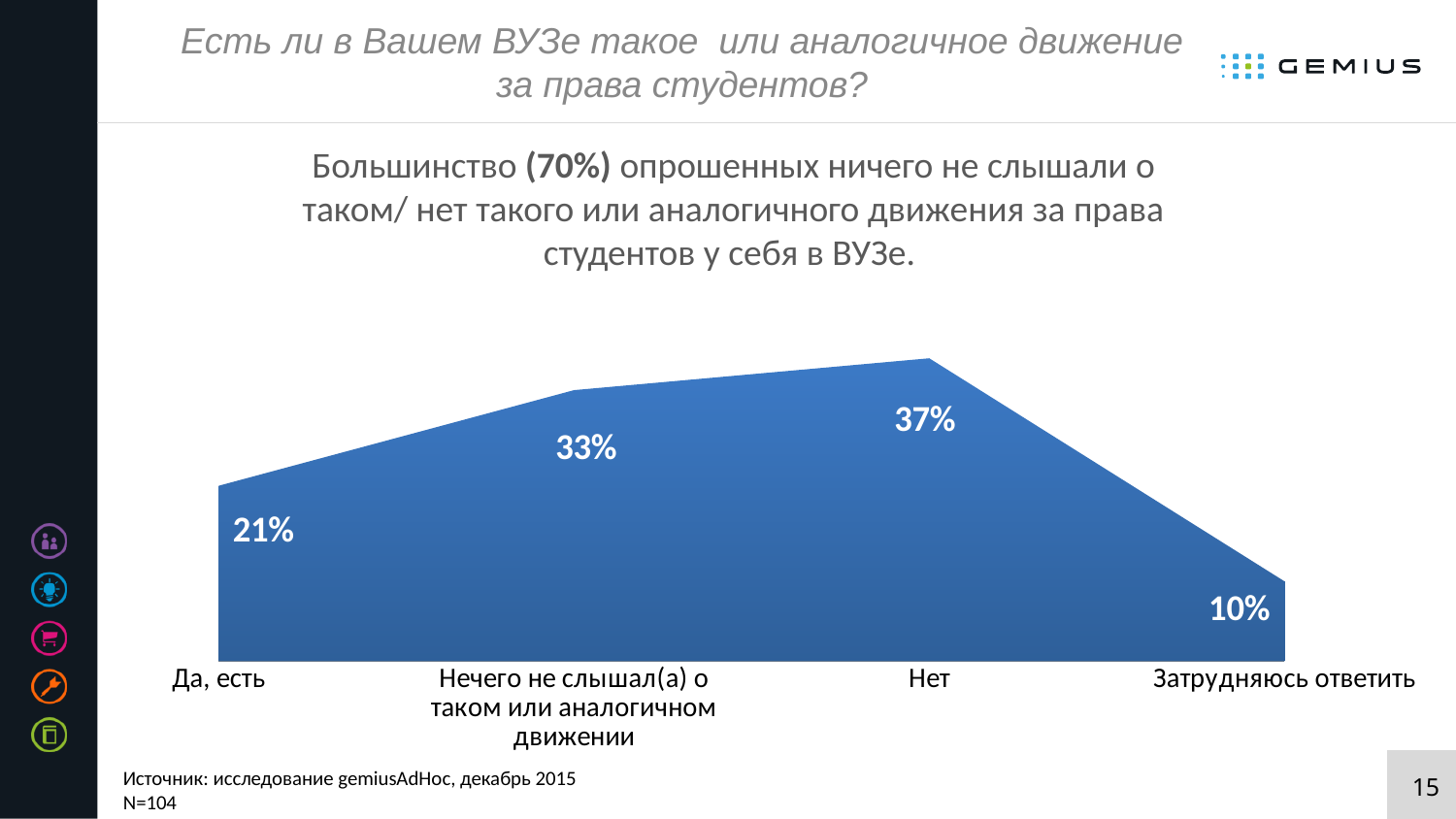
What kind of chart is shown on the slide? Area chart What value is shown for the category "Да, есть"? 21% What is the difference between the values for "Нет" and "Да, есть"? 16% Which category has the lowest value? Затрудняюсь ответить What value is shown for "Нечего не слышал(а) о таком или аналогичном движении"? 33% What is the sample size (N) stated at the bottom of the slide? N=104 What is the difference between the values for "Нечего не слышал(а) о таком или аналогичном движении" and "Затрудняюсь ответить"? 23% What value is shown for "Затрудняюсь ответить"? 10% How many categories are shown on the x axis of the chart? 4 Which category has the highest value? Нет Which is larger: the value for "Да, есть" or the value for "Нечего не слышал(а) о таком или аналогичном движении"? Нечего не слышал(а) о таком или аналогичном движении What value is shown for the category "Нет"? 37%